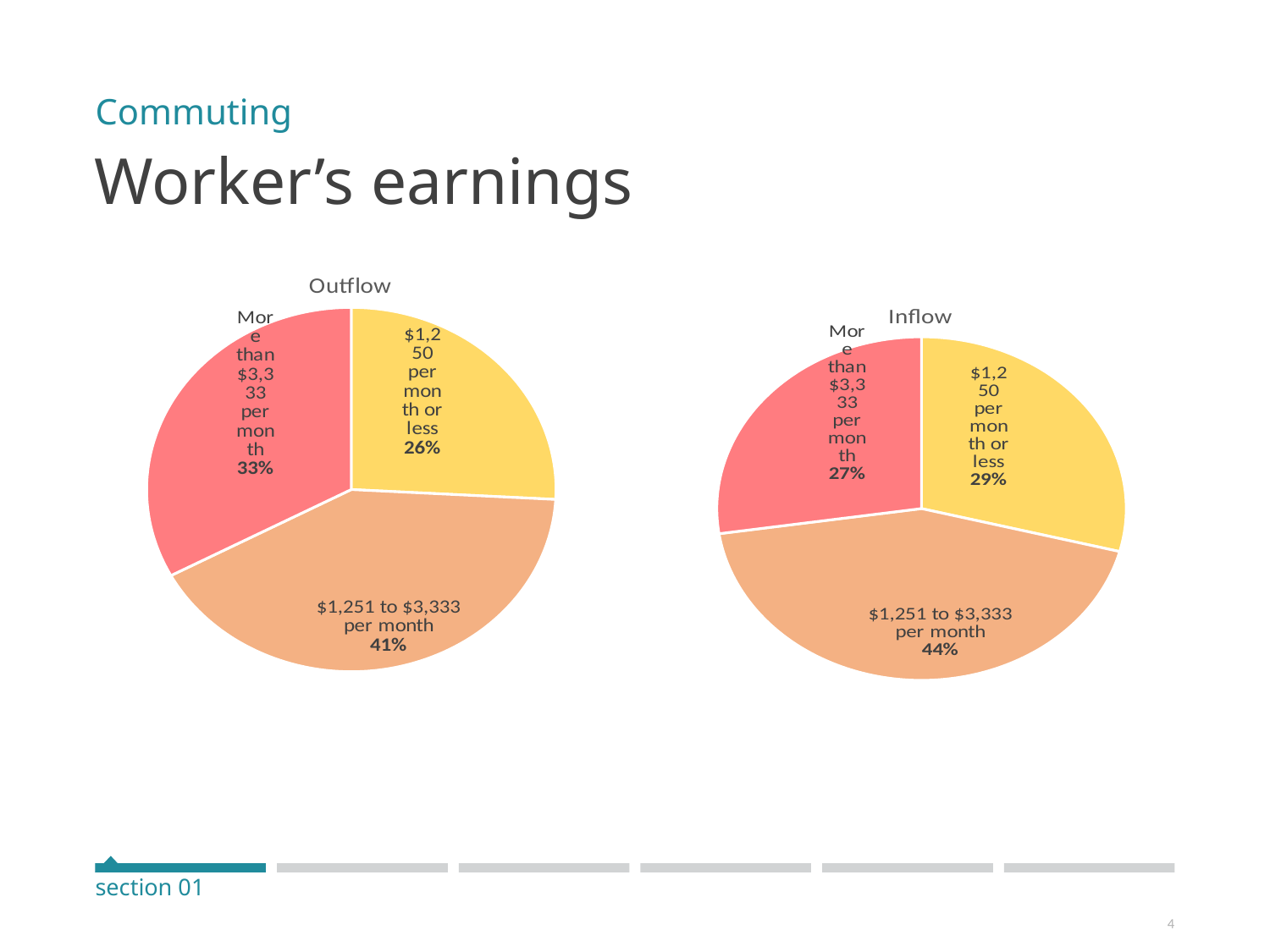
Which chart shows a larger share for workers earning more than $3,333 per month, Outflow or Inflow? Outflow In the Inflow chart, which earnings category has the smallest share? More than $3,333 per month In the Outflow chart, which earnings category has the smallest share? $1,250 per month or less In the Outflow chart, which earnings category has the largest share? $1,251 to $3,333 per month In the Inflow chart, what share of workers earn more than $3,333 per month? 27% How many earnings categories does the Inflow chart show? 3 What type of chart is the Outflow chart? Pie chart In the Outflow chart, what share of workers earn $1,251 to $3,333 per month? 41% What is the difference between the Inflow and Outflow shares for $1,251 to $3,333 per month? 3 percentage points In the Outflow chart, what share of workers earn more than $3,333 per month? 33% In the Inflow chart, what share of workers earn $1,250 per month or less? 29% What colour is the $1,250 per month or less slice in the Inflow chart? Yellow